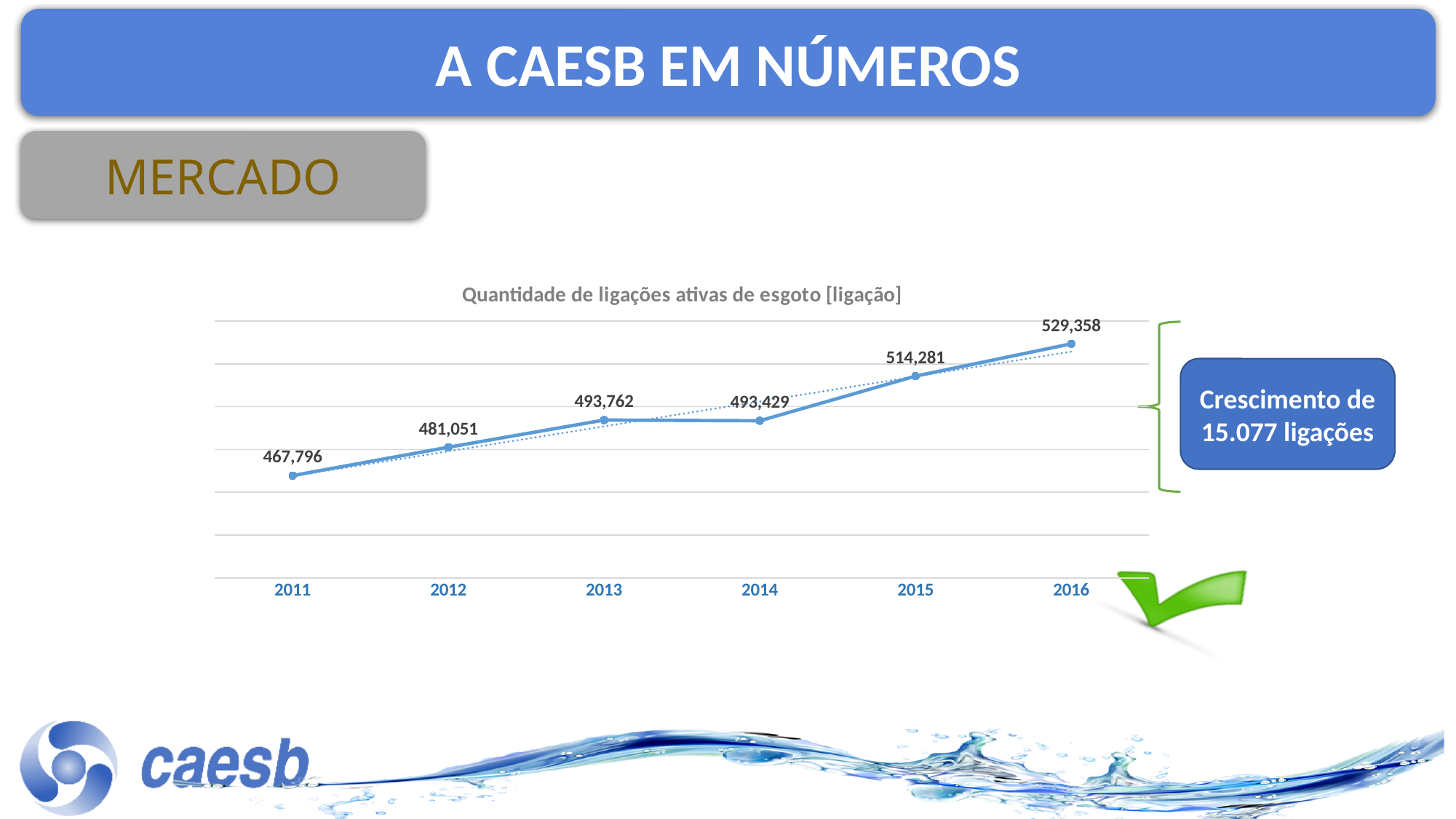
What is the value for 2011? 467,796 What is the difference between the values for 2016 and 2015? 15,077 What is the value for 2014? 493,429 Which year has the highest value? 2016 What is the difference between the values for 2013 and 2014? 333 What is the title of the chart? Quantidade de ligações ativas de esgoto [ligação] Which is larger, the value for 2012 or the value for 2015? 2015 Which year has the lowest value? 2011 Do the values generally rise or fall from 2011 to 2016? rise How many years are plotted on the x axis? 6 What is the value for 2016? 529,358 What type of chart is shown on the slide? line chart